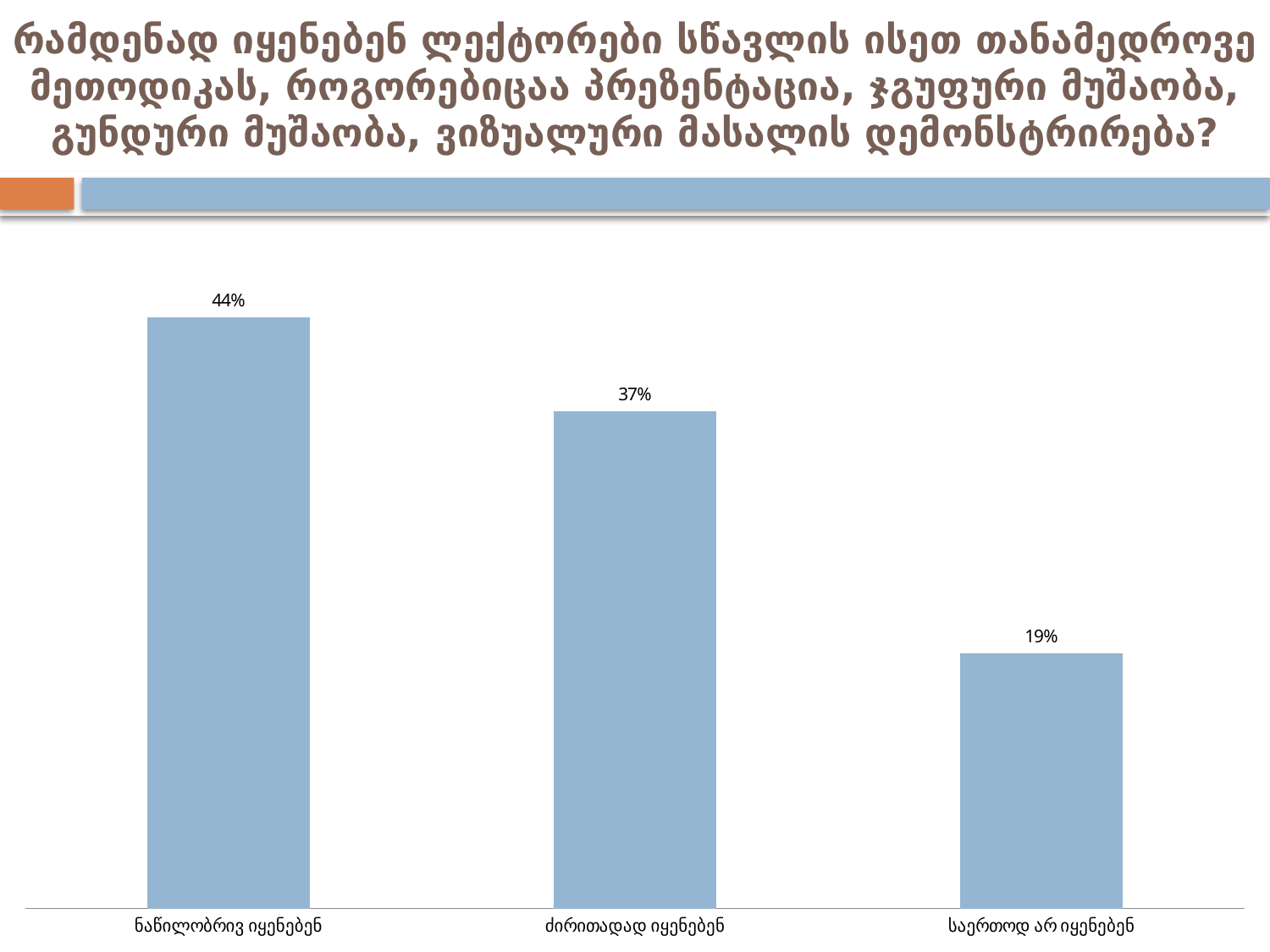
What is the difference between the values for ძირითადად იყენებენ and საერთოდ არ იყენებენ? 18% Which category has the lowest value? საერთოდ არ იყენებენ What colour are the bars in the chart? light blue Which category has the highest value? ნაწილობრივ იყენებენ What is the difference between the values for ნაწილობრივ იყენებენ and ძირითადად იყენებენ? 7% Do the values rise or fall from left to right across the categories? fall How many categories are shown in the chart? 3 What value is shown for ნაწილობრივ იყენებენ? 44% What value is shown for ძირითადად იყენებენ? 37% What value is shown for საერთოდ არ იყენებენ? 19% Which is larger, the value for ძირითადად იყენებენ or the value for საერთოდ არ იყენებენ? ძირითადად იყენებენ What kind of chart is shown on the slide? bar chart